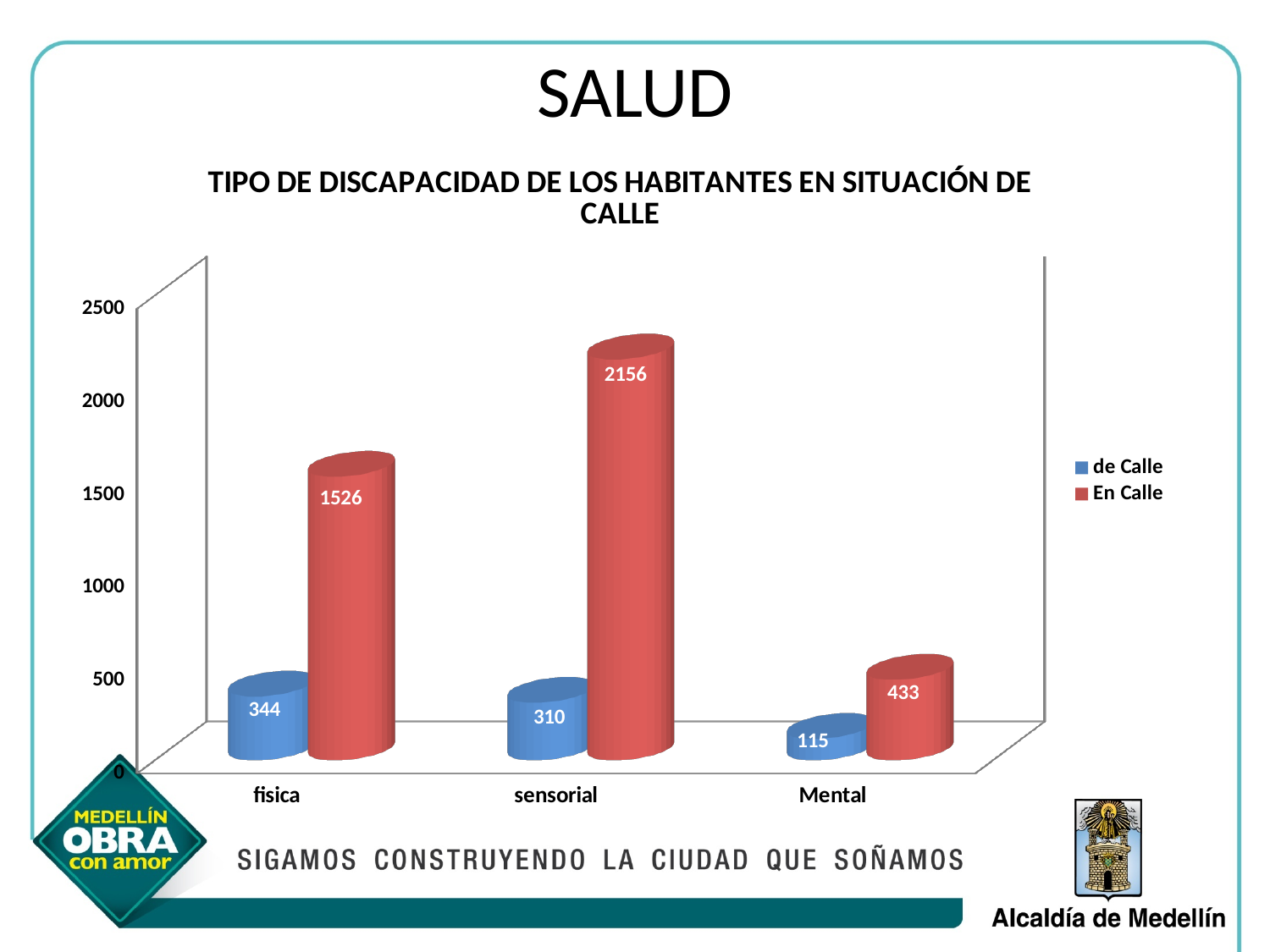
How many series does the legend list? 2 Which category has the highest 'En Calle' value? sensorial Is the 'En Calle' value for 'sensorial' greater or less than 2000? greater What is the value for 'de Calle' in the 'fisica' category? 344 What is the value for 'En Calle' in the 'sensorial' category? 2156 What colour are the 'En Calle' bars? red Which category has the lowest 'de Calle' value? Mental What is the difference between the 'En Calle' and 'de Calle' values for 'fisica'? 1182 Which is larger: the 'de Calle' value for 'fisica' or for 'sensorial'? fisica What is the value for 'En Calle' in the 'Mental' category? 433 What kind of chart is shown on the slide? bar chart How many categories are shown on the x axis? 3